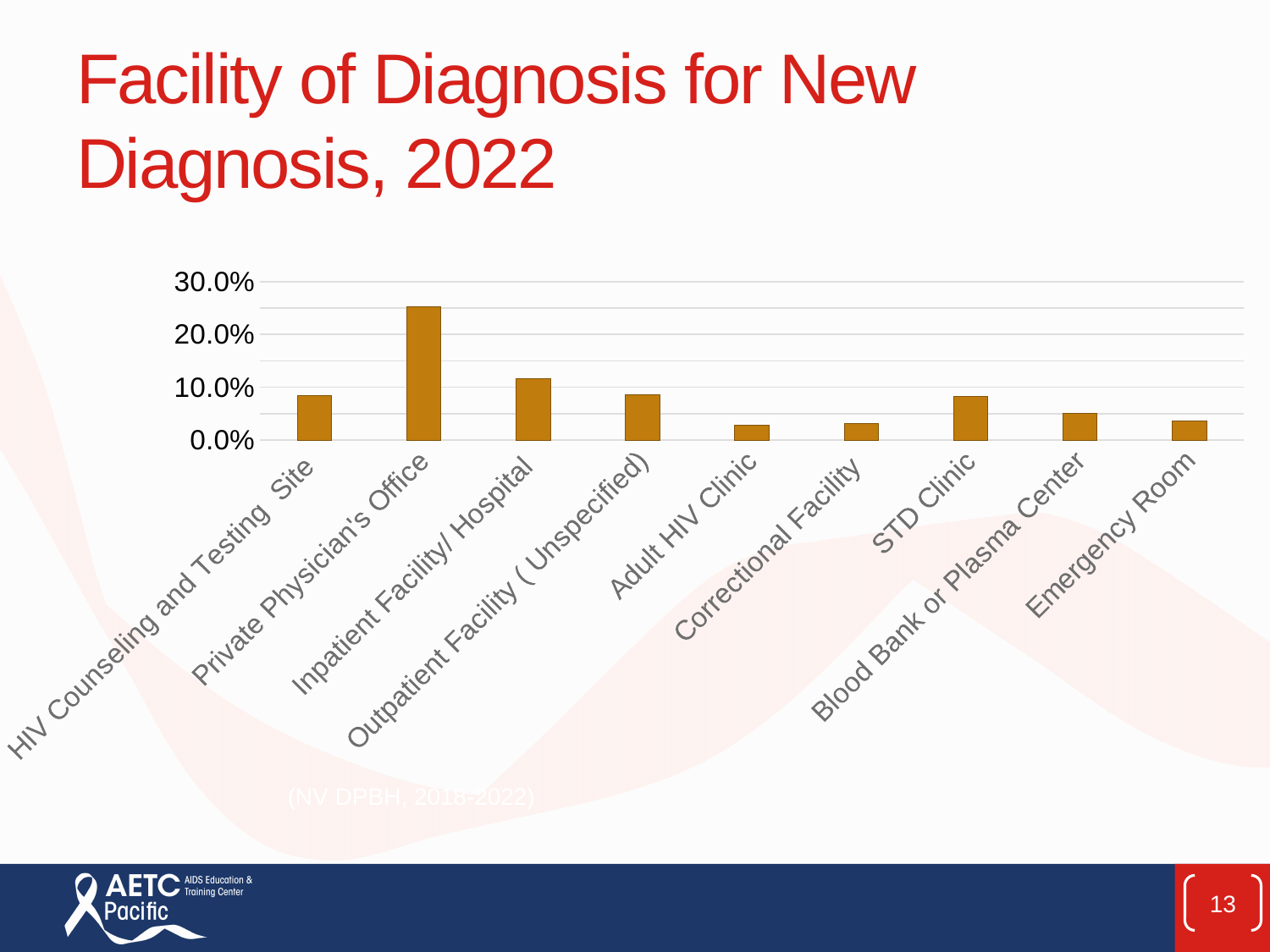
Which facility has the highest percentage of new diagnoses in the chart? Private Physician's Office Is the value for Adult HIV Clinic greater or less than 10.0%? less What type of chart is shown on the slide? Bar chart Is the value for Inpatient Facility/ Hospital greater or less than 10.0%? greater Which is larger: the value for Blood Bank or Plasma Center or the value for Adult HIV Clinic? Blood Bank or Plasma Center Is the value for Private Physician's Office greater or less than 20.0%? greater Which is larger: the value for Inpatient Facility/ Hospital or the value for STD Clinic? Inpatient Facility/ Hospital Which is larger: the value for Private Physician's Office or the value for Inpatient Facility/ Hospital? Private Physician's Office What is the highest value shown on the chart's y axis? 30.0% How many facility categories are shown on the x axis of the chart? 9 What is the title of the slide containing the chart? Facility of Diagnosis for New Diagnosis, 2022